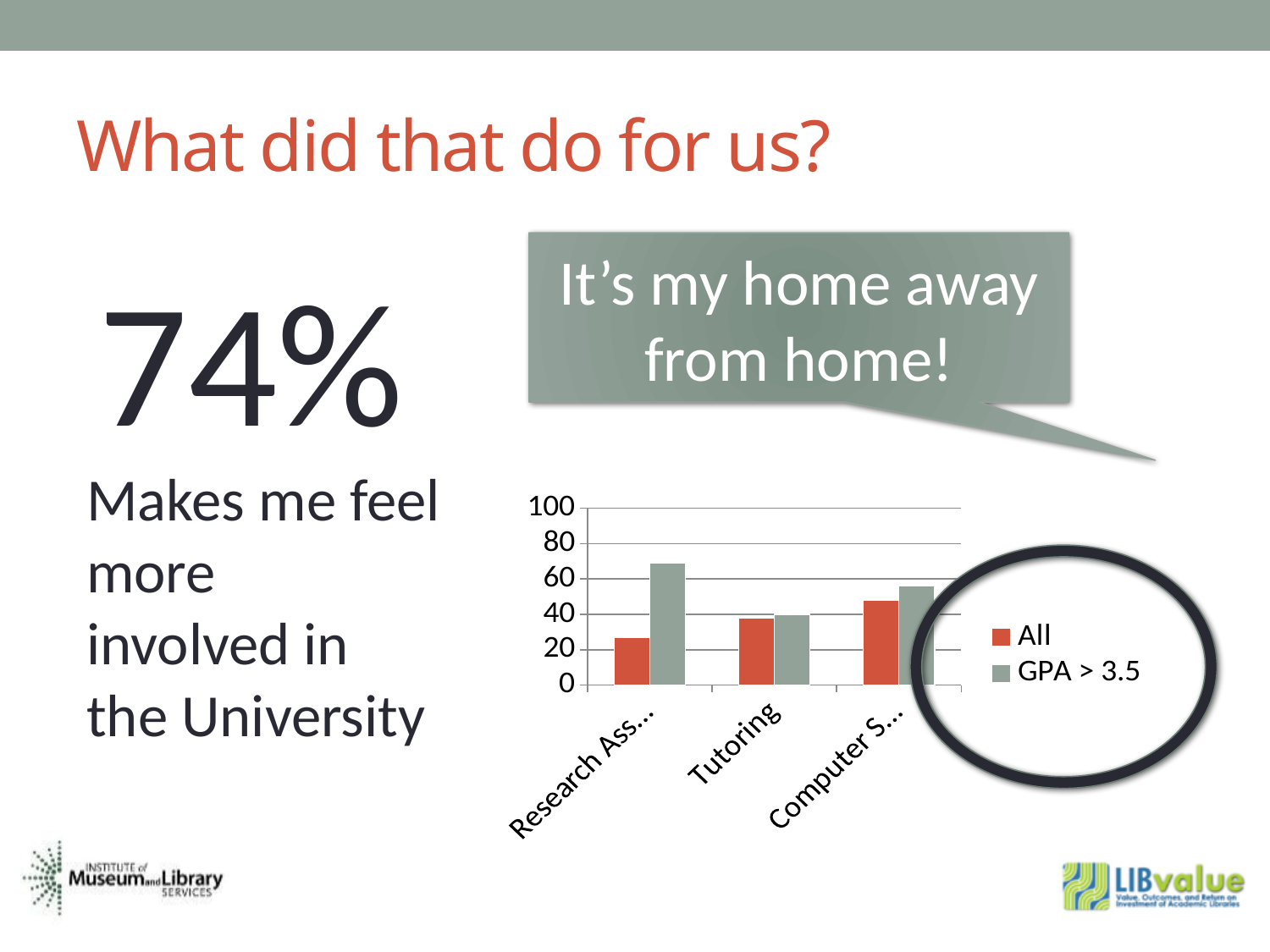
Which category has the lowest All bar? The first category (Research Ass...) What kind of chart is shown on the slide? Bar chart Is the All value for the first category on the left (Research Ass...) greater or less than 40? less Is the value for the All series in the Tutoring category greater or less than 20? greater Do the values for the All series rise or fall from left to right across the categories? Rise Which category has the highest GPA > 3.5 bar? The first category (Research Ass...) What are the two entries in the chart's legend? All and GPA > 3.5 How many categories are shown along the x axis of the chart? 3 Is the All value for the third category (Computer S...) greater or less than 40? greater How many series does the chart's legend list? 2 In the first category on the left (Research Ass...), which series has the larger bar, All or GPA > 3.5? GPA > 3.5